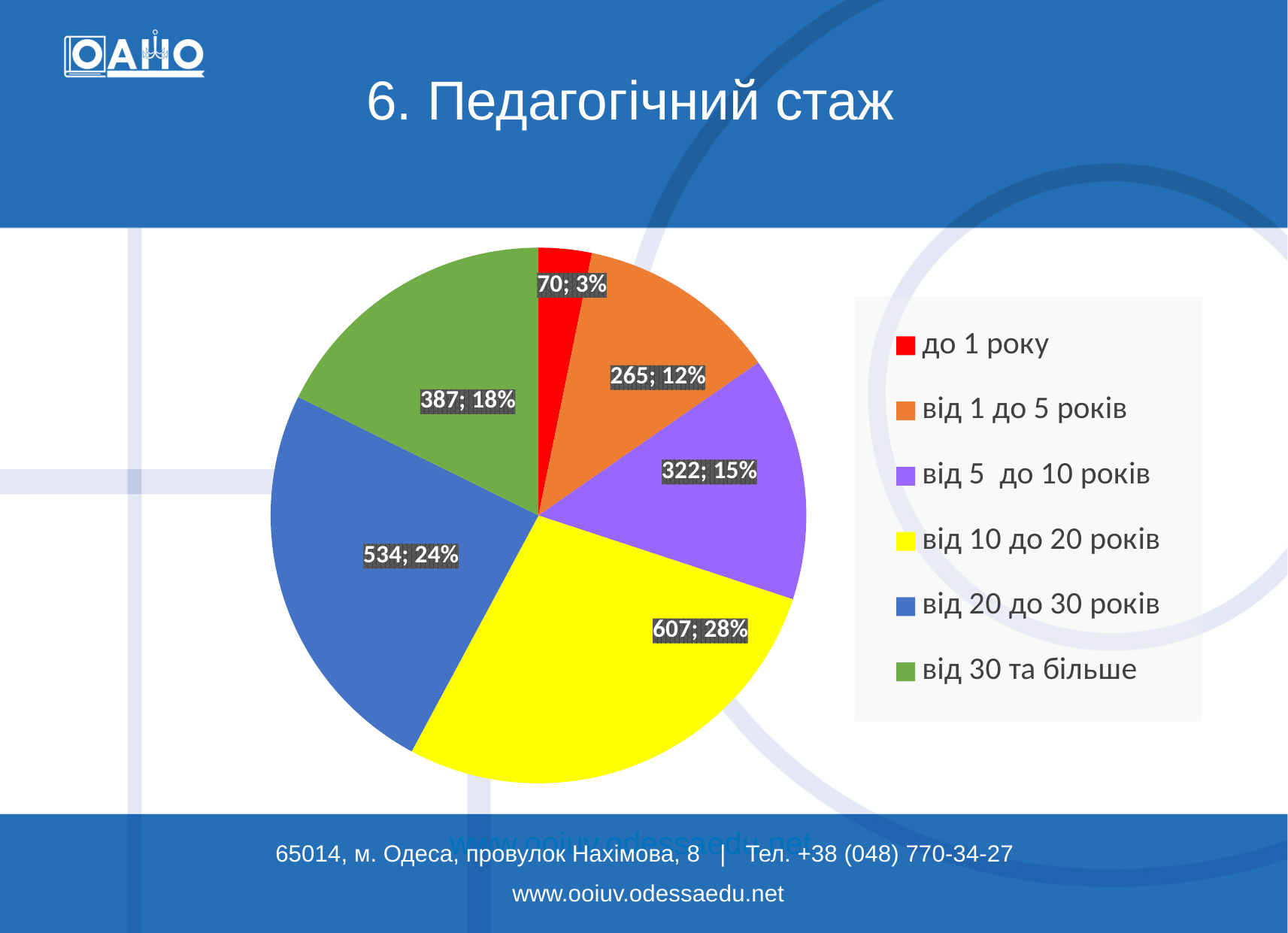
What percentage share does "від 20 до 30 років" have? 24% What is the title of the chart slide? 6. Педагогічний стаж Which category has the smallest slice? до 1 року What kind of chart is shown on the slide? pie chart What is the value for "від 10 до 20 років"? 607 How many categories does the pie chart have? 6 What is the difference between the values for "від 10 до 20 років" and "від 20 до 30 років"? 73 What is the value for "до 1 року"? 70 Which is larger, the value for "від 30 та більше" or the value for "від 5 до 10 років"? від 30 та більше Which category has the largest slice? від 10 до 20 років What colour is the slice for "від 1 до 5 років"? orange What percentage share does "від 5 до 10 років" have? 15%